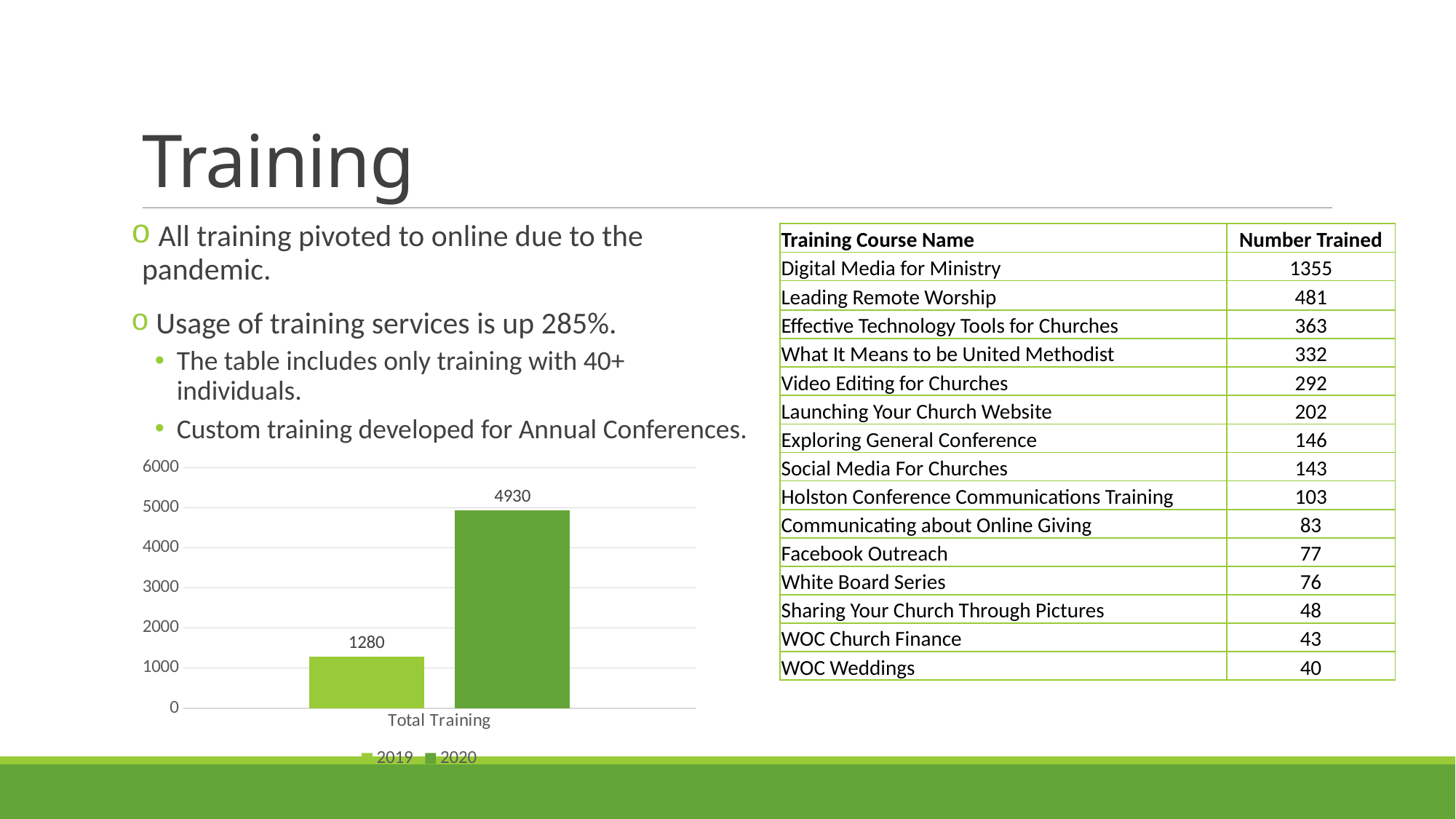
What are the two legend entries in the chart? 2019 and 2020 What is the highest value shown on the y axis of the chart? 6000 Is the value for 2019 in the Total Training chart greater or less than 2000? less How many categories are shown on the x axis of the chart? 1 How many series does the legend of the Total Training chart list? 2 What is the category label on the x axis of the chart? Total Training What kind of chart is shown on the slide? bar chart What is the value for 2019 in the Total Training chart? 1280 Which series has the higher value in the Total Training chart, 2019 or 2020? 2020 What is the value for 2020 in the Total Training chart? 4930 Is the value for 2020 in the Total Training chart greater or less than 4000? greater What is the difference between the 2020 and 2019 values in the Total Training chart? 3650